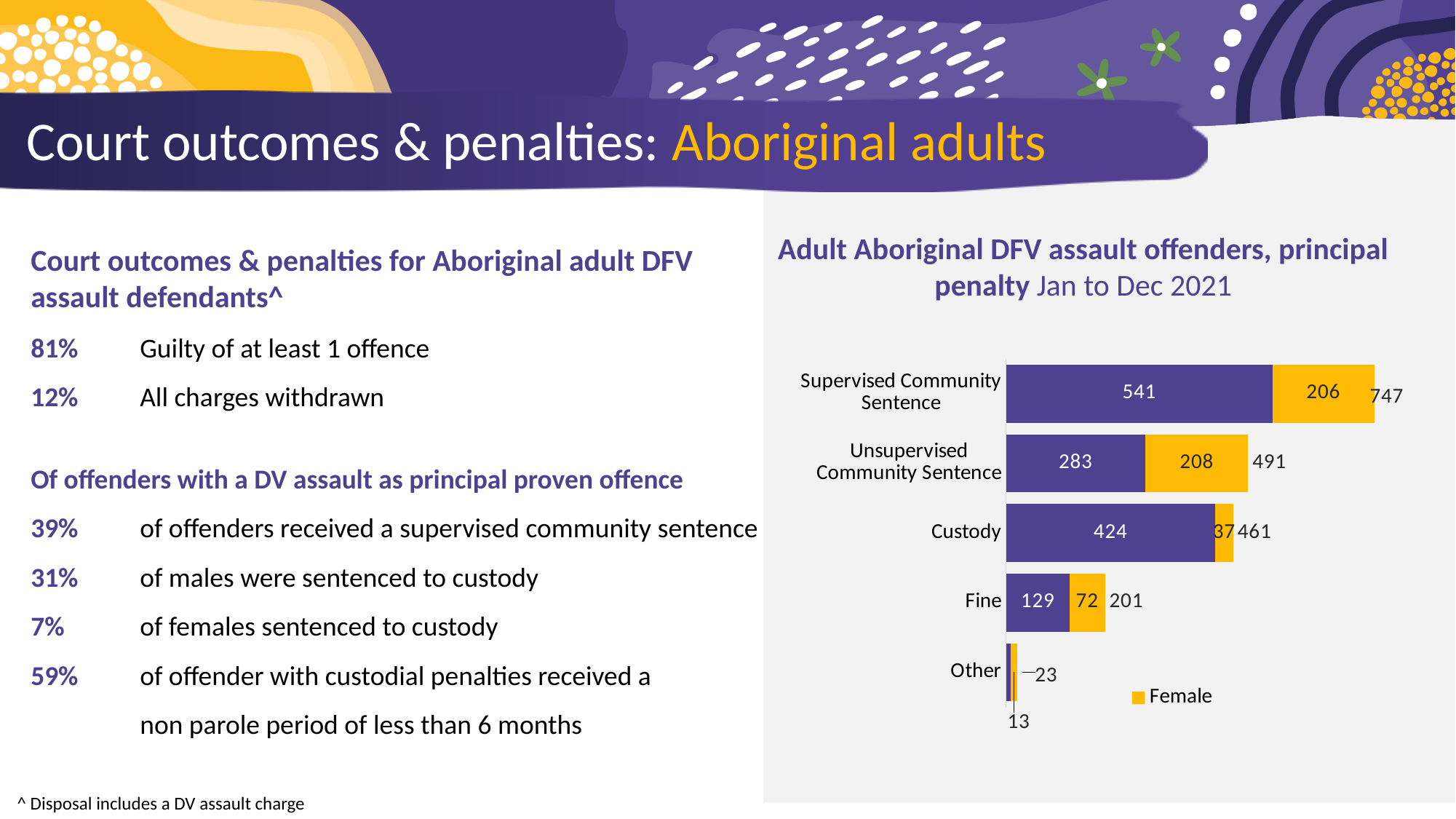
Which has a larger Female value, Fine or Custody? Fine What kind of chart is shown on the slide? Stacked bar chart What is the difference between the totals for Supervised Community Sentence and Unsupervised Community Sentence? 256 What is the Female value for Supervised Community Sentence? 206 What is the only series entry shown in the chart's legend? Female Which penalty category has the lowest total? Other What is the total shown for Custody? 461 How many series does the chart's legend list? 1 How many penalty categories are shown in the chart? 5 What is the total shown for Fine? 201 What is the Female value for Fine? 72 Which penalty category has the highest total? Supervised Community Sentence